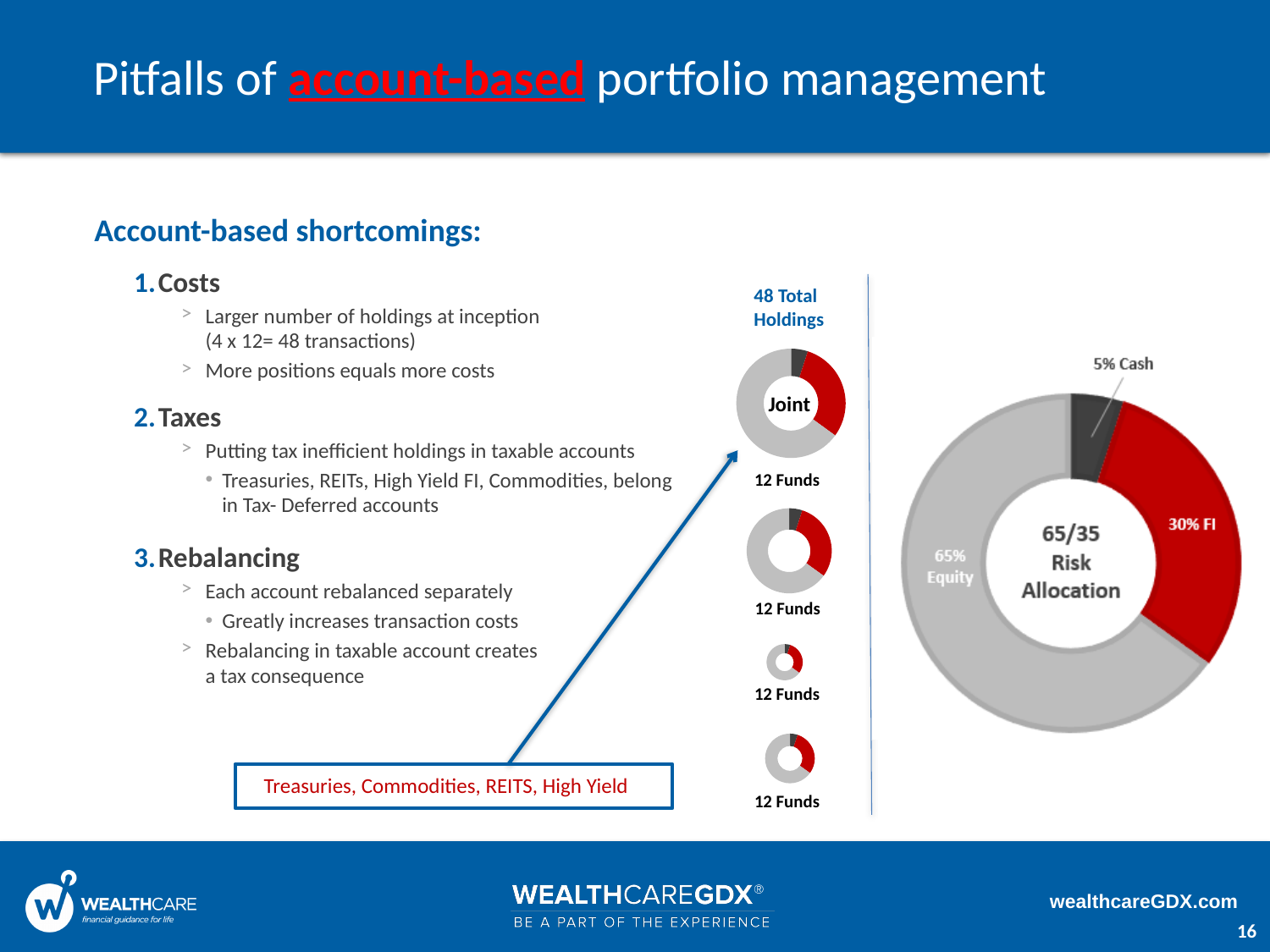
On the large donut chart on the right, how many percentage points larger is the Equity share than the FI share? 35 How many slices does the large donut chart on the right have? 3 What text is printed in the centre of the large donut chart on the right? 65/35 Risk Allocation What kind of chart is the large chart on the right of the slide? Donut (pie) chart On the large donut chart on the right, which slice is the largest? Equity On the large donut chart on the right, what share of the portfolio is allocated to Equity? 65% How many small donut charts are stacked in the column to the left of the large donut chart? 4 On the large donut chart on the right, which slice is the smallest? Cash What label is printed below each of the four small donut charts? 12 Funds On the large donut chart on the right, what share of the portfolio is allocated to FI? 30% FI On the large donut chart on the right, what share of the portfolio is Cash? 5% Cash On the large donut chart on the right, which is larger, the FI share or the Cash share? FI